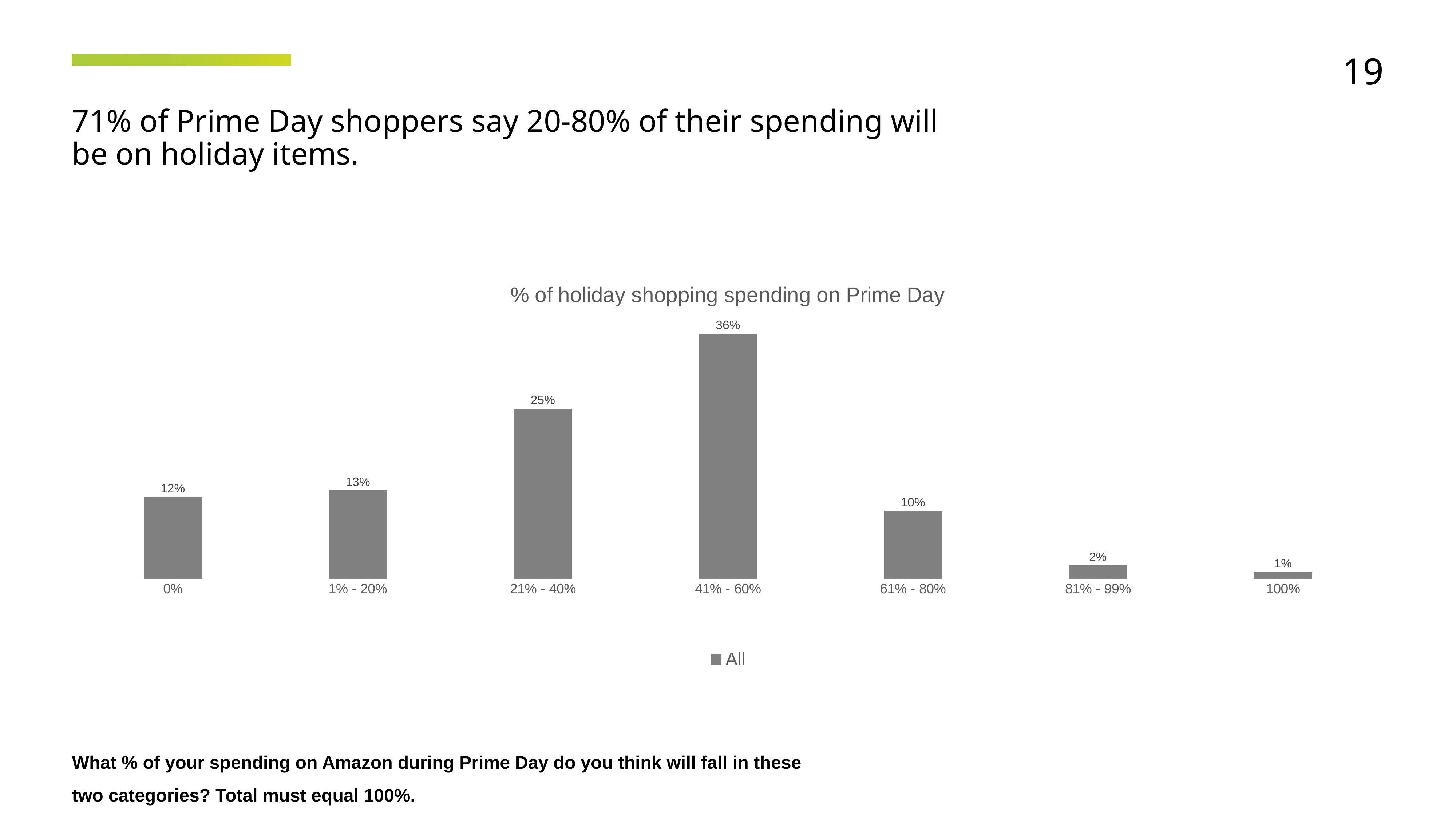
What kind of chart is shown? bar chart Which category has the lowest value? 100% What is the name of the series in the legend? All What is the difference between the values for 41% - 60% and 21% - 40%? 11% Which category has the highest value? 41% - 60% Which is larger, the value for 1% - 20% or the value for 61% - 80%? 1% - 20% What is the value for the 0% category? 12% What is the value for the 61% - 80% category? 10% How many series does the legend list? 1 What is the value for the 41% - 60% category? 36% What is the title of the chart? % of holiday shopping spending on Prime Day How many categories are shown on the x axis? 7